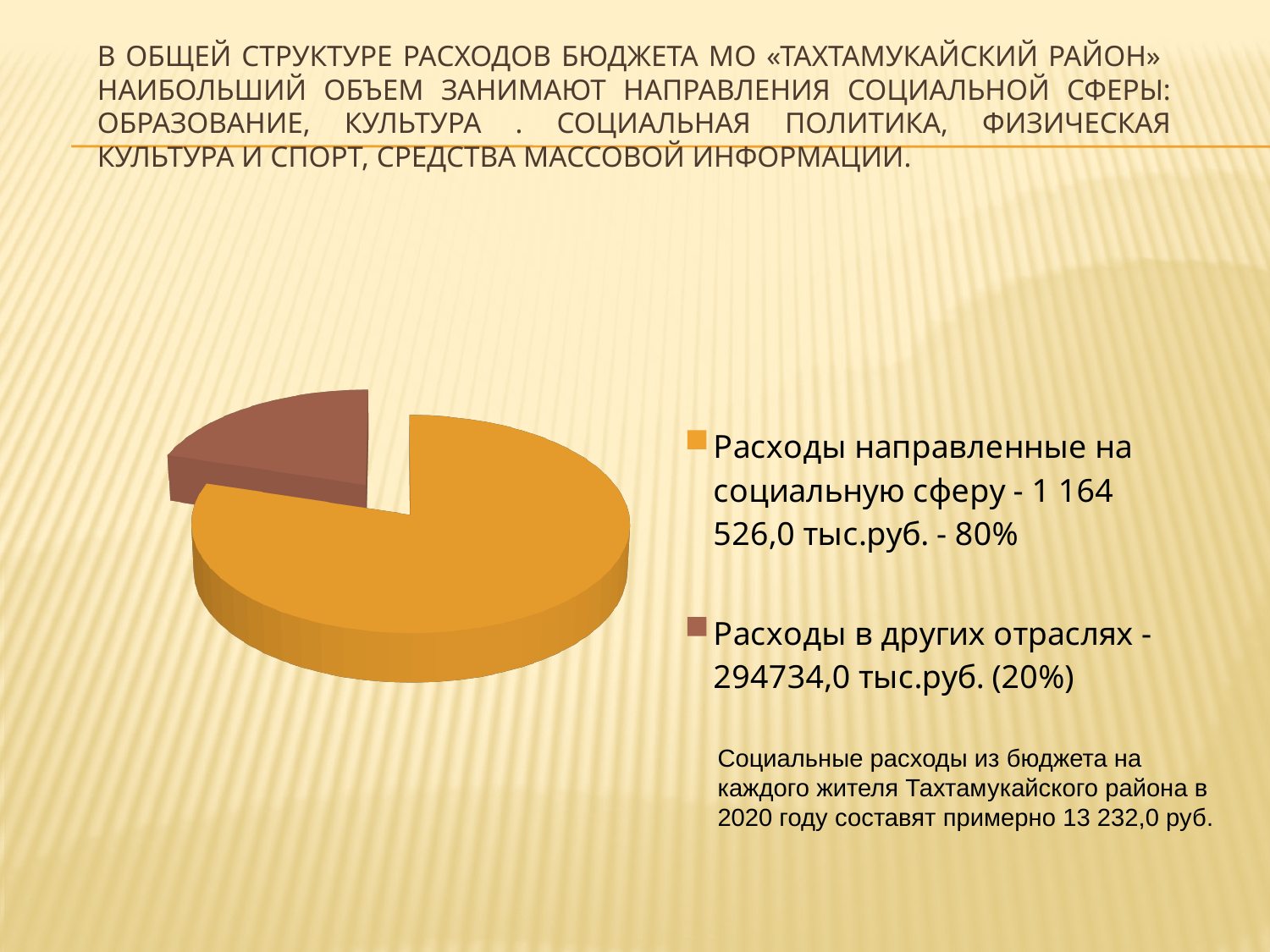
What is the difference in percentage points between the two slices of the pie chart? 60 What is the value for "Расходы в других отраслях" in thousand rubles? 294734,0 тыс.руб. Which slice of the pie chart is the largest? Расходы направленные на социальную сферу Which is larger: the share for "Расходы направленные на социальную сферу" or for "Расходы в других отраслях"? Расходы направленные на социальную сферу What is the value for "Расходы направленные на социальную сферу" in thousand rubles? 1 164 526,0 тыс.руб. Which slice of the pie chart is the smallest? Расходы в других отраслях What share of the pie is taken by "Расходы в других отраслях"? 20% What share of the pie is taken by "Расходы направленные на социальную сферу"? 80% How many entries does the legend of the pie chart list? 2 How many slices does the pie chart have? 2 What colour is the slice for "Расходы в других отраслях"? brown What kind of chart is shown on the slide? pie chart